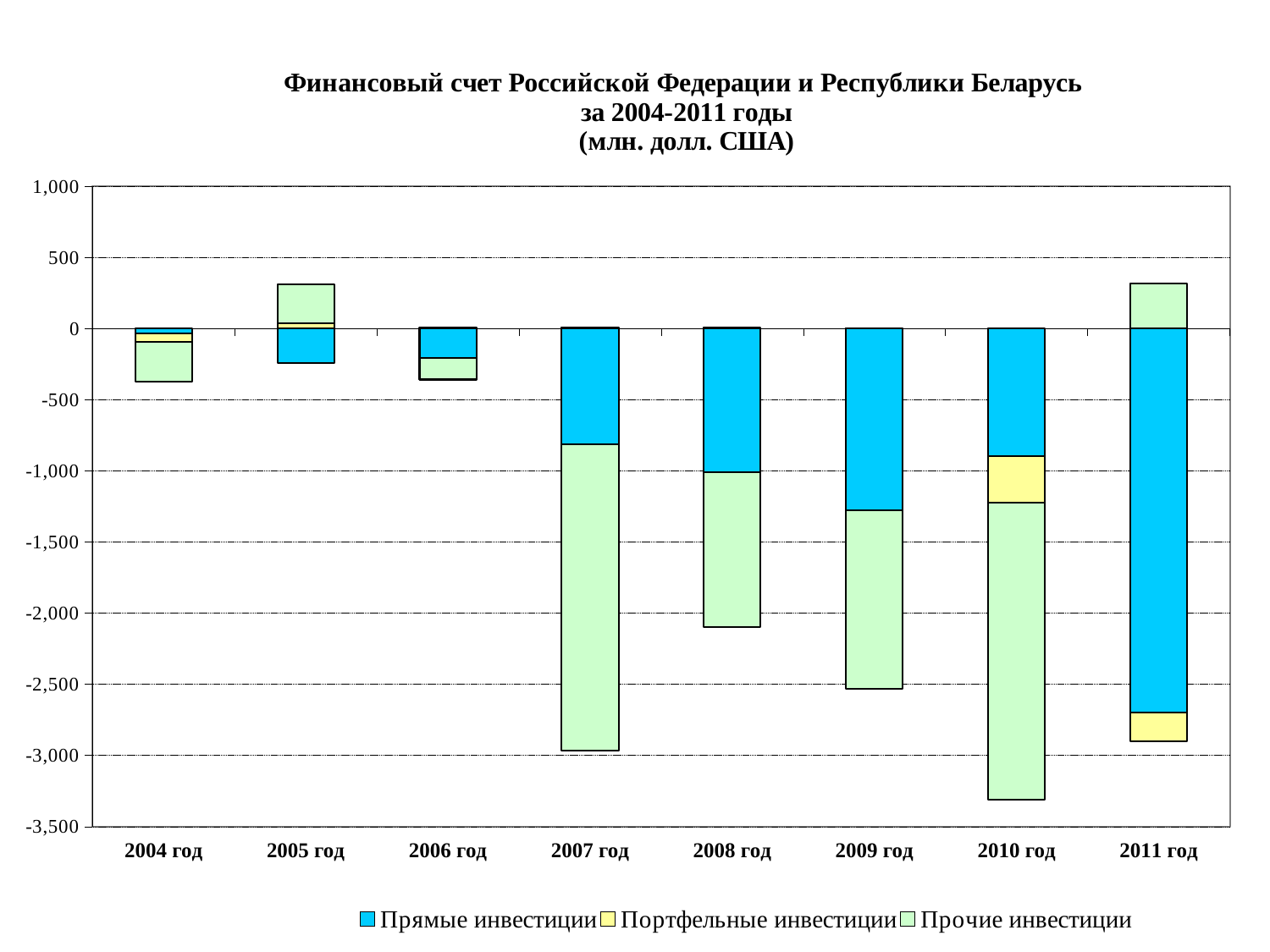
Is the Прочие инвестиции value for 2011 год greater or less than 0? greater Is the Прочие инвестиции value for 2005 год greater or less than 500? less Which colour represents Прямые инвестиции in the chart? Blue What kind of chart is shown on the slide? Stacked bar chart In which year does the stacked bar reach the lowest (most negative) point? 2010 год How many series does the legend list? 3 How many years (categories) are shown on the x axis? 8 What is the title of the chart? Финансовый счет Российской Федерации и Республики Беларусь за 2004-2011 годы (млн. долл. США) In which year is the Прямые инвестиции segment the largest in magnitude (most negative)? 2011 год Which year has the larger negative Прочие инвестиции segment, 2007 год or 2008 год? 2007 год Is the Прямые инвестиции value for 2007 год greater or less than -500? less